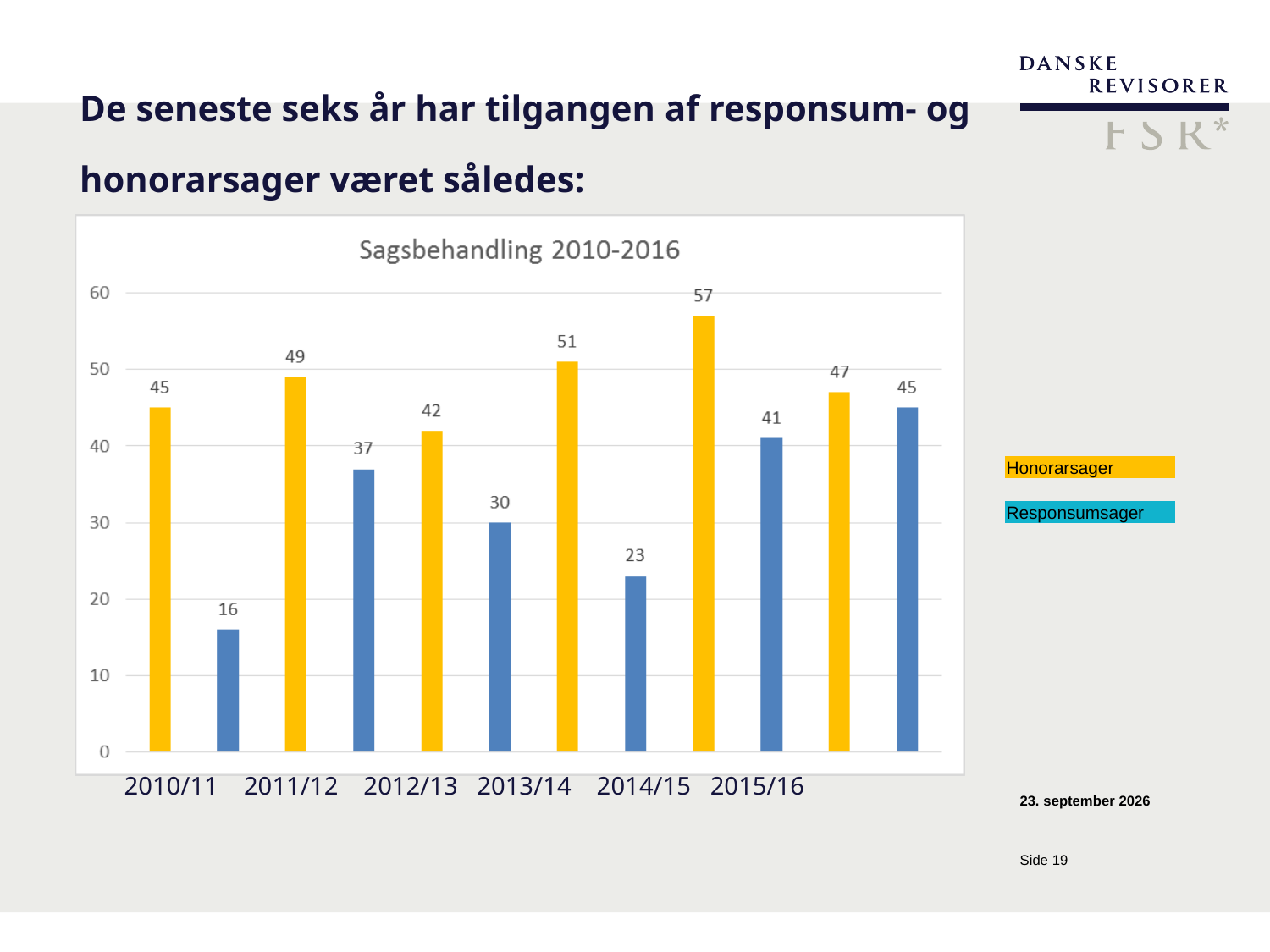
What is the title of the chart? Sagsbehandling 2010-2016 In which year is the Responsumsager value lowest? 2010/11 How many years are shown on the x axis? 6 What is the value for Responsumsager in 2010/11? 16 What is the difference between Honorarsager and Responsumsager in 2011/12? 12 In which year is the Honorarsager value highest? 2014/15 What kind of chart is shown? bar chart Which is larger in 2013/14, Honorarsager or Responsumsager? Honorarsager Is the value for Responsumsager in 2012/13 greater or less than 40? less How many series does the legend list? 2 What is the value for Responsumsager in 2015/16? 45 What is the value for Honorarsager in 2014/15? 57